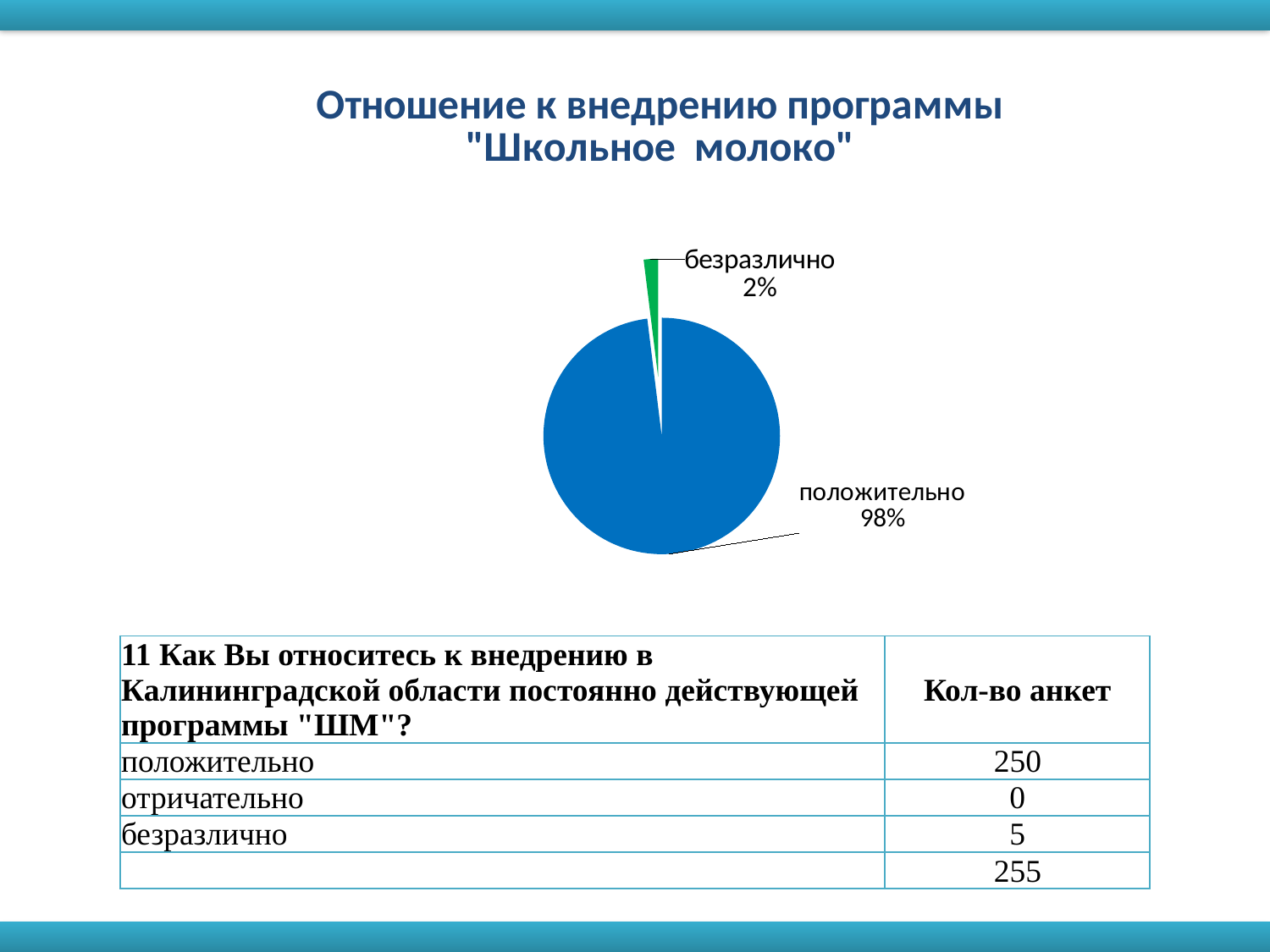
Which slice of the pie chart is the smallest? безразлично What share of the pie does the "безразлично" slice represent? 2% What share of the pie does the "положительно" slice represent? 98% Which slice of the pie chart is the largest? положительно What is the difference in percentage points between the "положительно" and "безразлично" slices? 96 What is the title of the chart? Отношение к внедрению программы "Школьное молоко" How many labelled slices does the pie chart show? 2 Which is larger in the pie chart, "положительно" or "безразлично"? положительно What colour is the "безразлично" slice in the pie chart? green What kind of chart is shown on the slide? pie chart